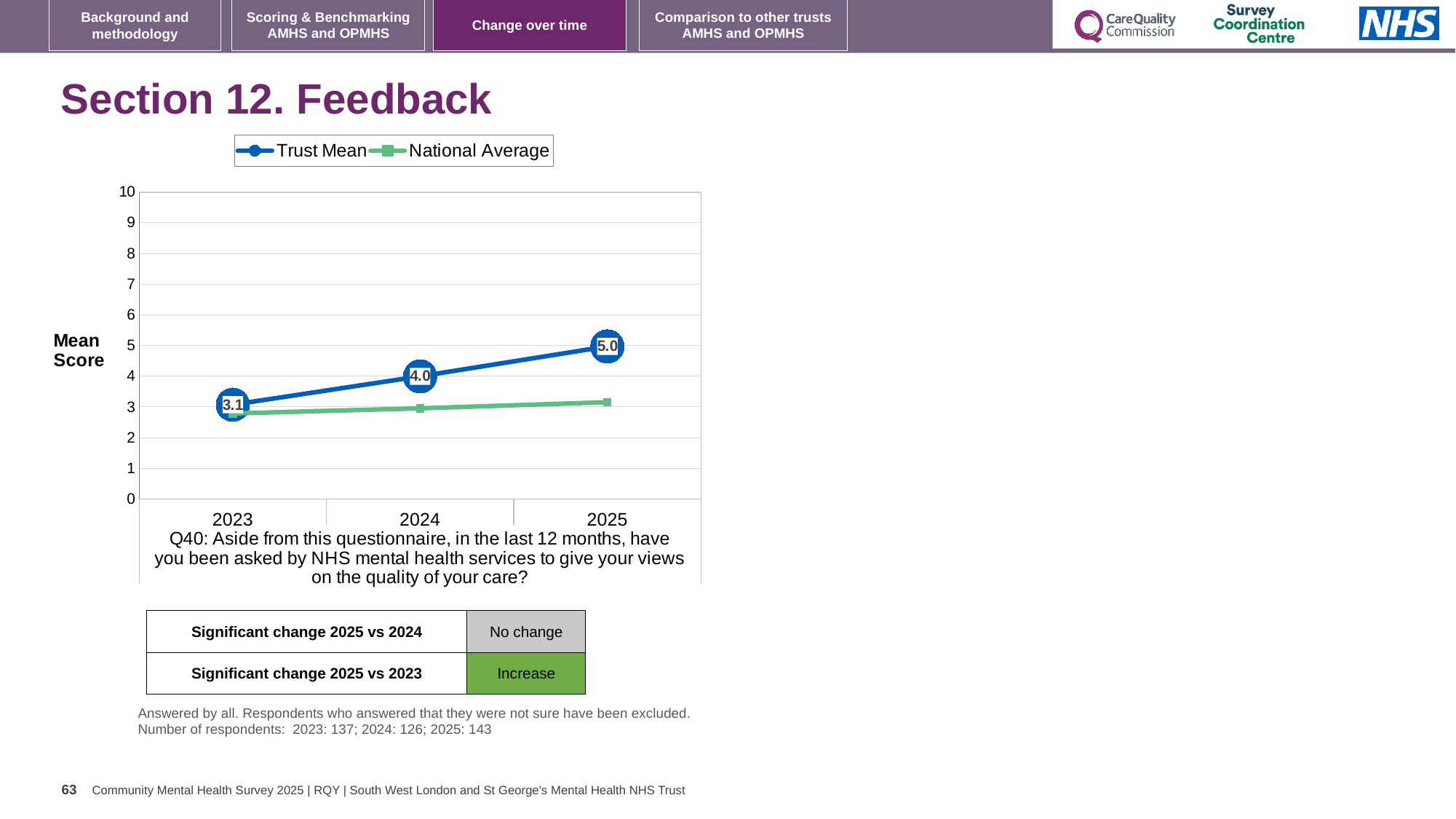
Does the Trust Mean rise or fall from 2023 to 2025? rise What is the Trust Mean score for 2023? 3.1 What kind of chart is shown? line chart In which year is the Trust Mean lowest? 2023 What is the Trust Mean score for 2025? 5.0 How many years are shown on the x axis? 3 Is the National Average for 2025 greater or less than 4? less What is the difference between the Trust Mean in 2025 and in 2023? 1.9 How many series does the legend list? 2 What is the Trust Mean score for 2024? 4.0 Which is larger in 2025, the Trust Mean or the National Average? Trust Mean In which year is the Trust Mean highest? 2025